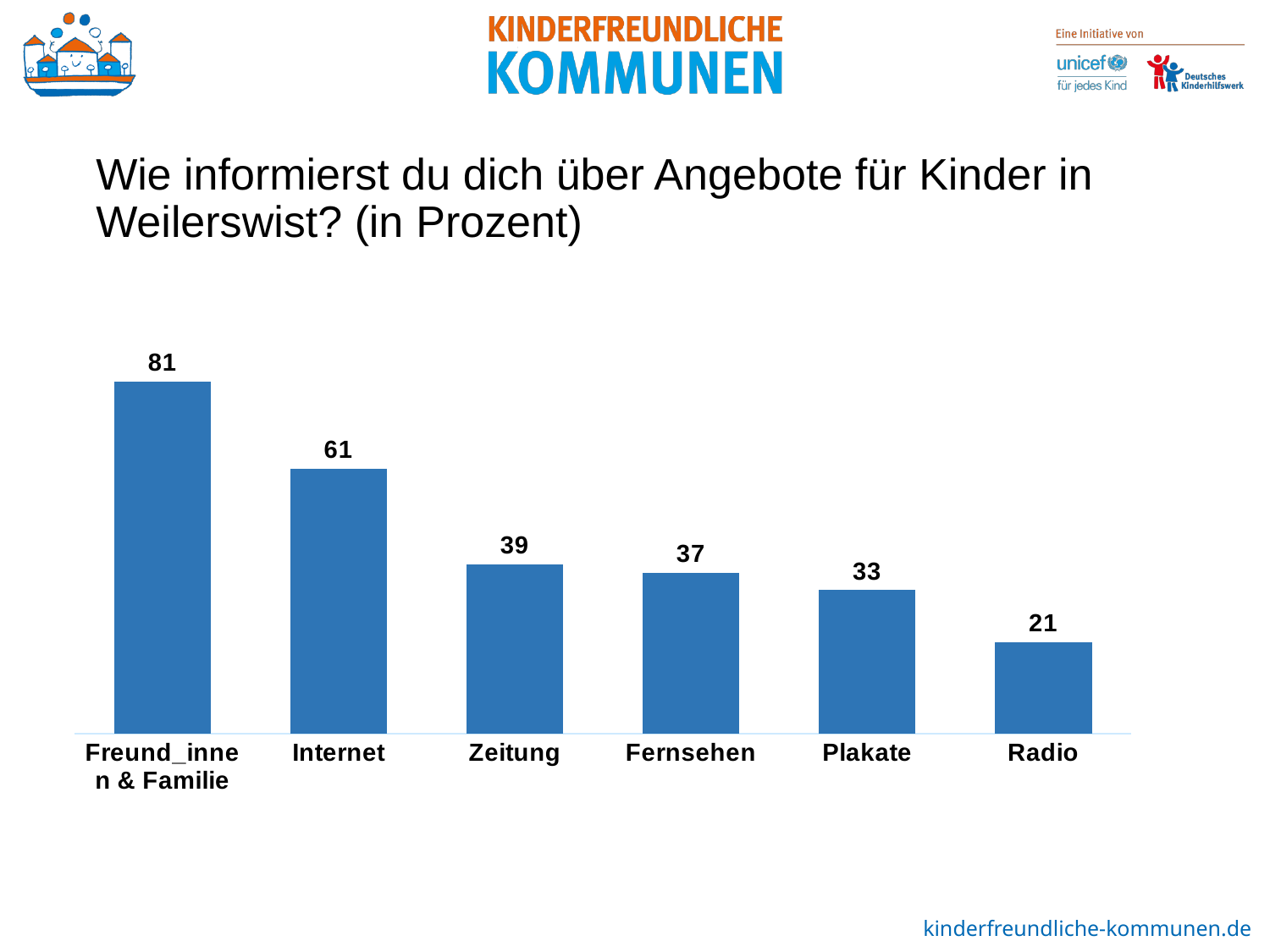
Which is larger, the value for Fernsehen or the value for Plakate? Fernsehen What is the value for Radio? 21 What is the title of the slide above the chart? Wie informierst du dich über Angebote für Kinder in Weilerswist? (in Prozent) How many categories are shown in the chart? 6 What is the difference between the values for Zeitung and Fernsehen? 2 What is the difference between the values for Freund_innen & Familie and Internet? 20 What kind of chart is shown on the slide? Bar chart Which category has the highest value? Freund_innen & Familie Which category has the lowest value? Radio Do the values rise or fall from left to right across the categories? Fall What is the value for Internet? 61 What is the value for Plakate? 33